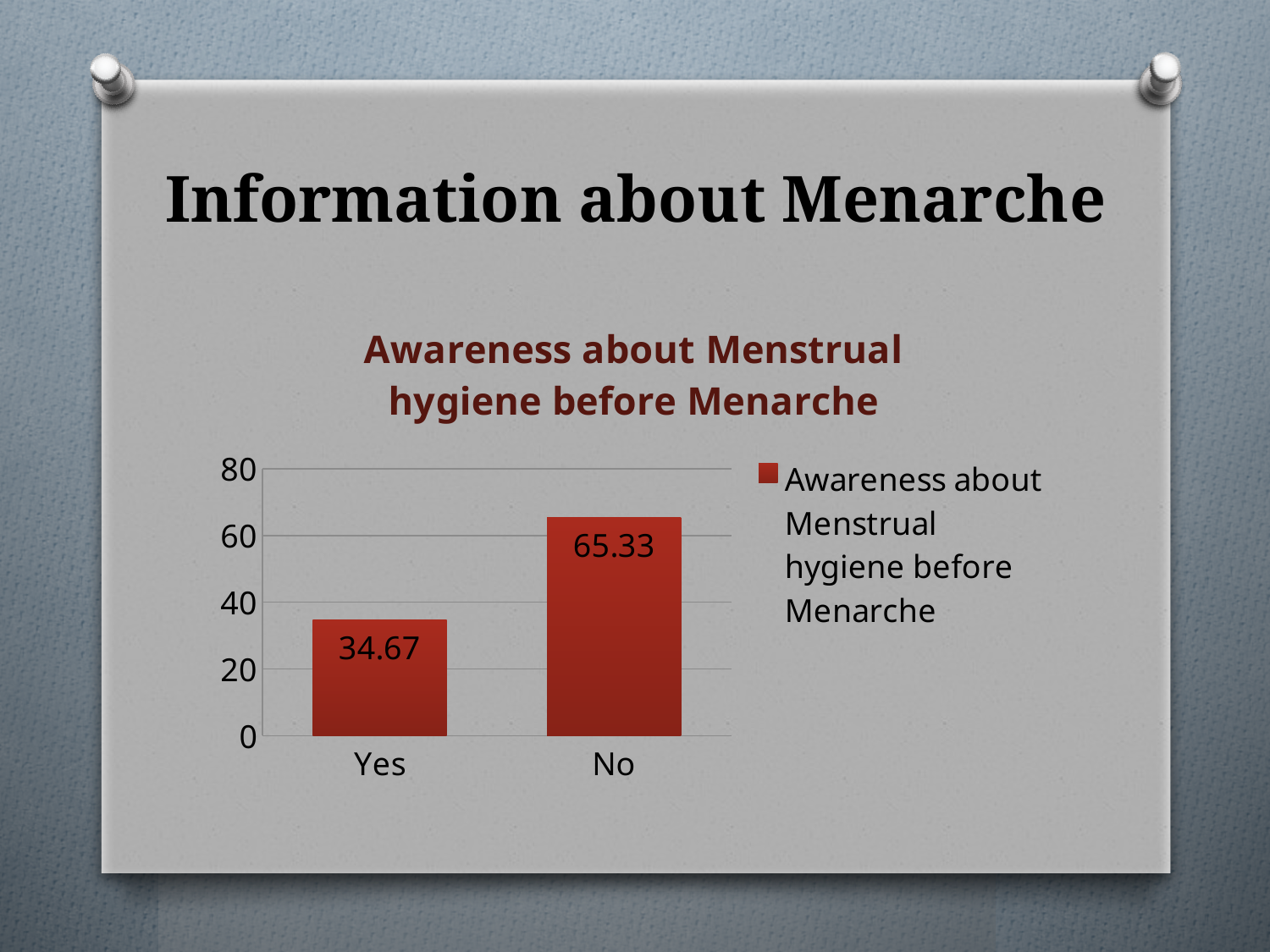
How many categories are shown on the x axis? 2 What is the difference between the values for "No" and "Yes"? 30.66 What is the value for "Yes" in the chart? 34.67 Which category has the highest value? No How many series does the legend list? 1 What is the title of the chart? Awareness about Menstrual hygiene before Menarche What kind of chart is shown on the slide? bar chart Which is larger, the value for "Yes" or the value for "No"? No What is the value for "No" in the chart? 65.33 Is the value for "No" greater or less than 60? greater Is the value for "Yes" greater or less than 40? less Which category has the lowest value? Yes